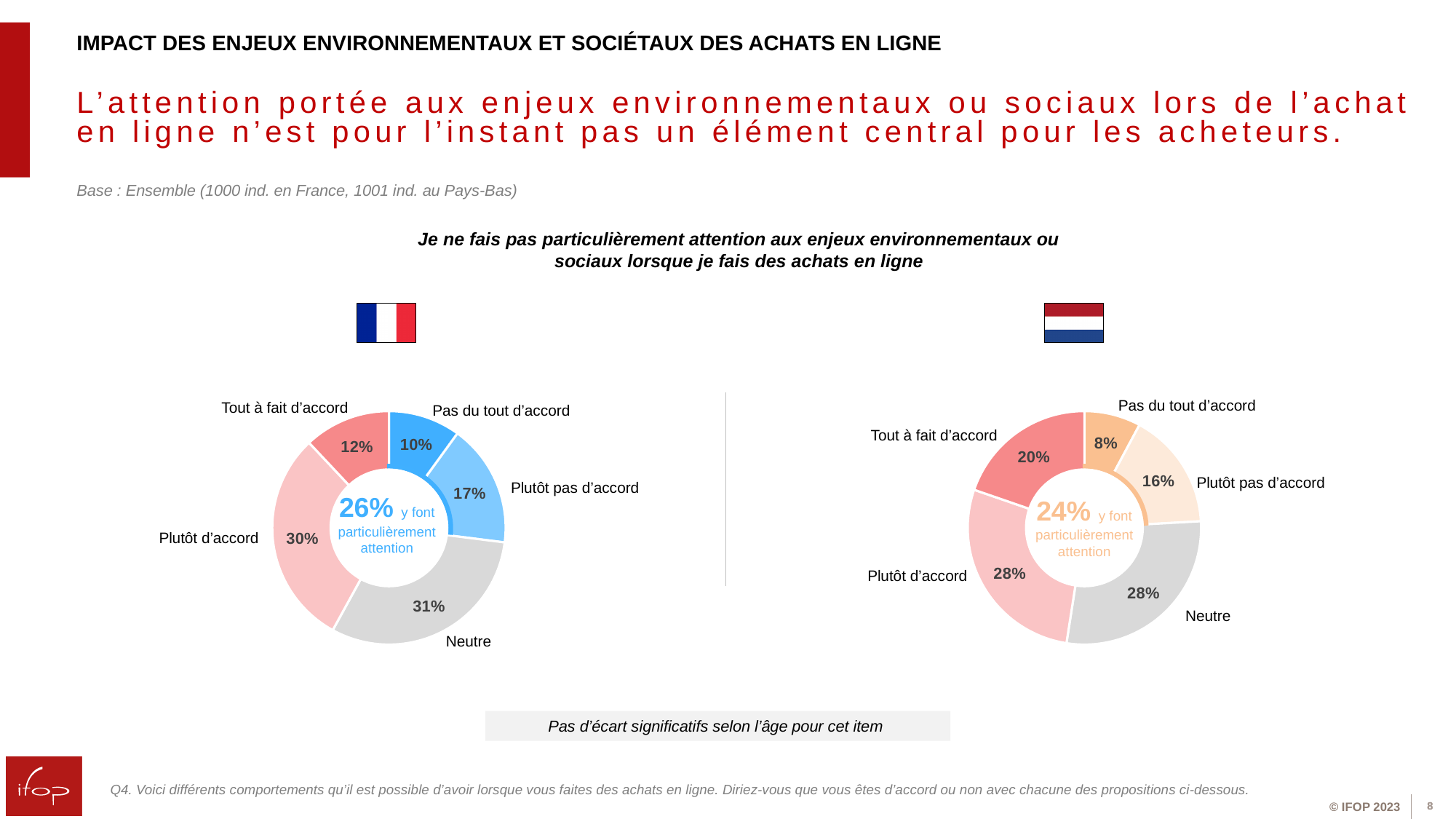
In the right (Netherlands) donut chart, which category has the smallest share? Pas du tout d'accord In the left (France) donut chart, which category has the largest share? Neutre Which chart shows a larger value for "Tout à fait d'accord", the left (France) chart or the right (Netherlands) chart? The right (Netherlands) chart In the left (France) donut chart, what is the value for "Neutre"? 31% What is the difference between the "Plutôt d'accord" values in the left (France) chart and the right (Netherlands) chart? 2 percentage points In the right (Netherlands) donut chart, what is the value for "Tout à fait d'accord"? 20% In the left (France) donut chart, which category has the smallest share? Pas du tout d'accord What percentage is shown in the centre of the right (Netherlands) donut chart as paying particular attention? 24% What type of chart is used on this slide? Donut (pie) chart In the left (France) donut chart, what is the value for "Plutôt pas d'accord"? 17% How many categories are shown in the left (France) donut chart? 5 In the right (Netherlands) donut chart, what is the value for "Pas du tout d'accord"? 8%